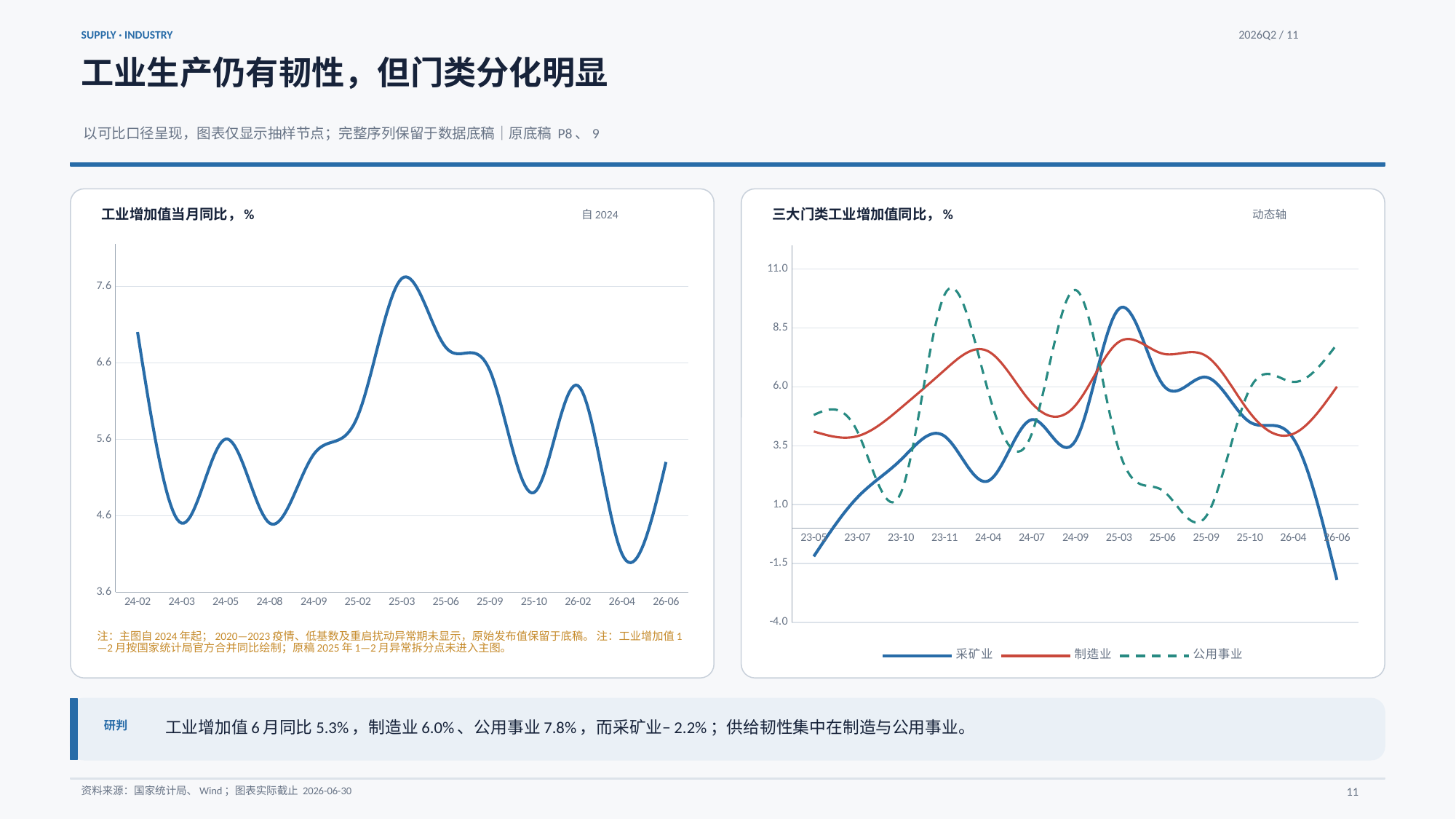
In the left chart (工业增加值当月同比，%), which is larger, the value for 26-02 or the value for 26-06? 26-02 In the left chart (工业增加值当月同比，%), how many points are labelled on the x axis? 13 In the right chart (三大门类工业增加值同比，%), which series has the lowest value at 26-06? 采矿业 In the left chart (工业增加值当月同比，%), is the value for 24-02 greater or less than 6.6? greater What are the legend entries of the right chart (三大门类工业增加值同比，%)? 采矿业, 制造业, 公用事业 How many series does the legend of the right chart (三大门类工业增加值同比，%) list? 3 In the right chart (三大门类工业增加值同比，%), does the 采矿业 line rise or fall from 26-04 to 26-06? fall In the right chart (三大门类工业增加值同比，%), is the value of 采矿业 at 26-06 greater or less than 1.0? less In the left chart (工业增加值当月同比，%), at which x-axis label is the value lowest? 26-04 In the left chart (工业增加值当月同比，%), at which x-axis label is the value highest? 25-03 What kind of chart is the left chart titled 工业增加值当月同比，%? line chart In the left chart (工业增加值当月同比，%), is the value for 26-04 greater or less than 4.6? less